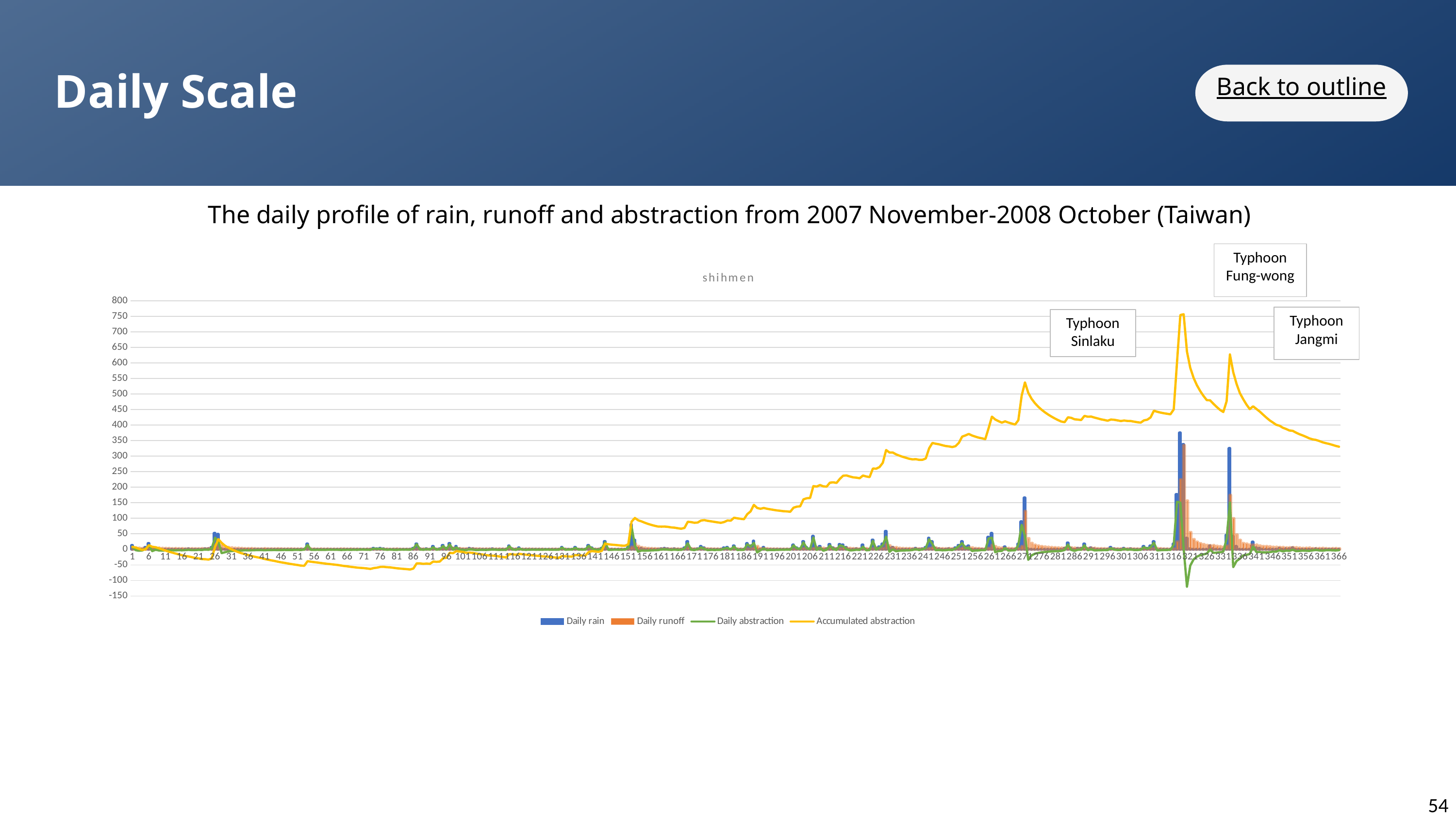
Which series reaches the highest value on the chart? Accumulated abstraction What is the highest value shown on the y axis? 800 Is the peak value of Accumulated abstraction greater or less than 700? greater What kind of chart is this? Combined bar and line chart Is the lowest value of Daily abstraction greater or less than -100? less Is the highest Daily rain bar greater or less than 300? greater How many series does the legend list? 4 Does Accumulated abstraction generally rise or fall between day 151 and day 316? rise What is the title shown above the plot area? shihmen What is the last label on the x axis? 366 Which series is drawn in yellow? Accumulated abstraction Which is larger at its peak, Daily rain or Daily runoff? Daily rain